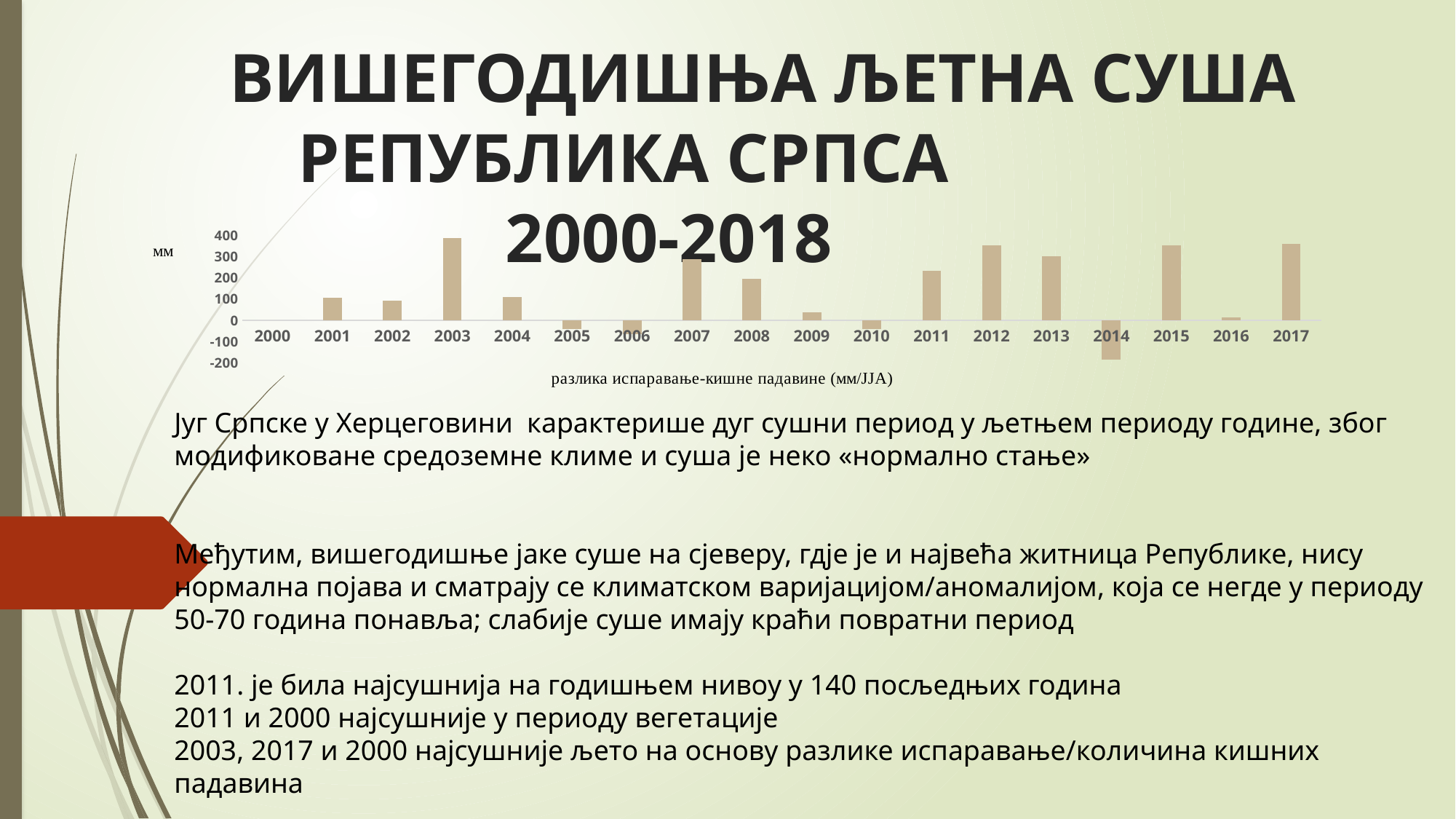
Which year has the lowest value in the chart? 2014 Is the value for 2011 greater or less than 200? greater How many years are shown on the x axis of the chart? 18 Which is larger, the value for 2012 or the value for 2009? 2012 Is the value for 2014 greater or less than -100? less What kind of chart is shown on the slide? bar chart Is the value for 2009 greater or less than 100? less What unit is written next to the vertical axis of the chart? мм Which year has the highest value in the chart? 2003